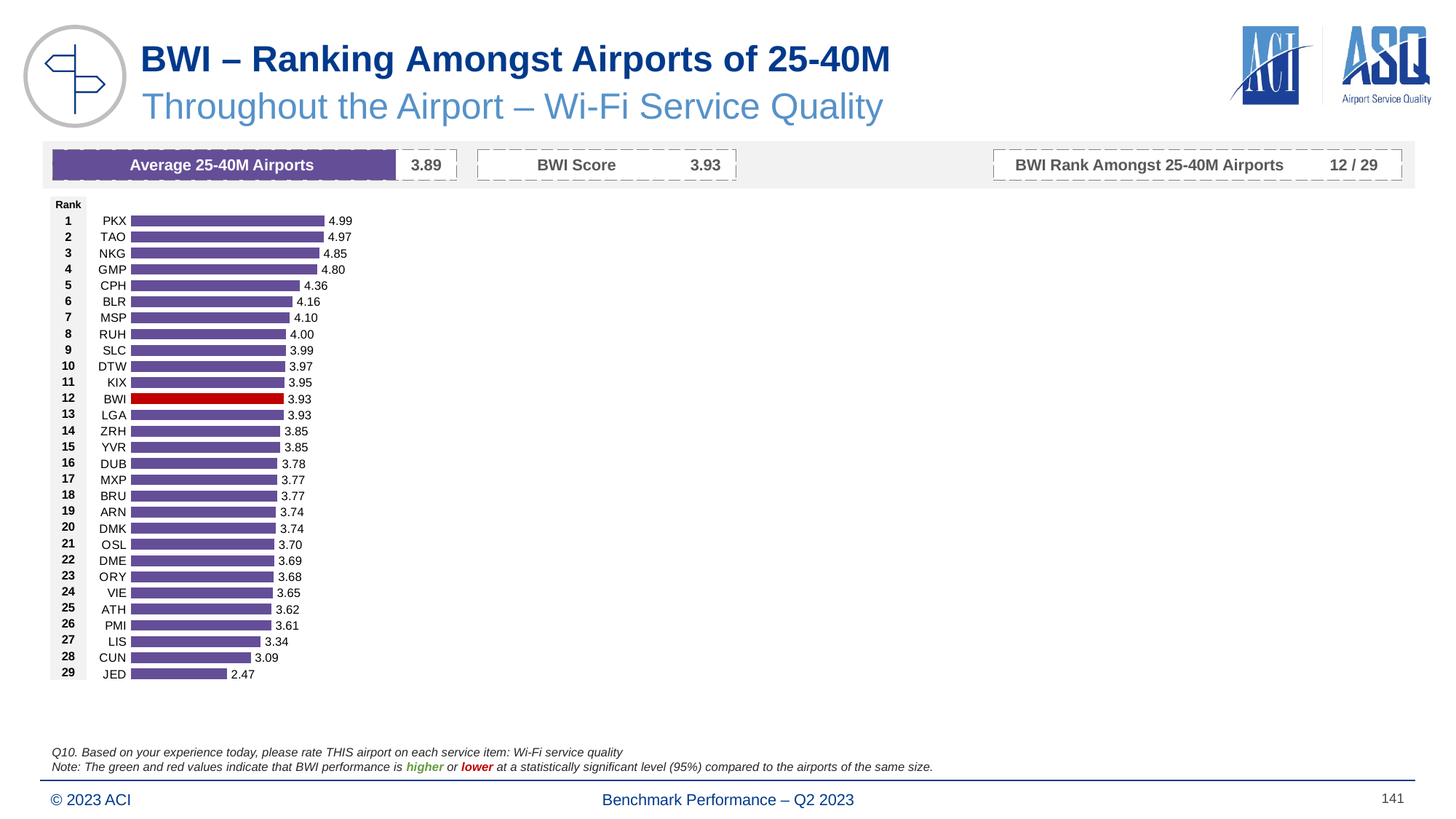
What is the difference between the scores of PKX and JED? 2.52 What is the score for CPH? 4.36 What is the Wi-Fi service quality score for BWI? 3.93 What is the score for LIS? 3.34 What is the difference between the BWI score and the average for 25-40M airports? 0.04 What is BWI's rank amongst 25-40M airports? 12 / 29 Which airport has the highest score? PKX Which has a higher score, MSP or DUB? MSP Which bar is highlighted in red in the chart? BWI How many airports are ranked in the chart? 29 What kind of chart is shown on the slide? Bar chart Which airport has the lowest score? JED